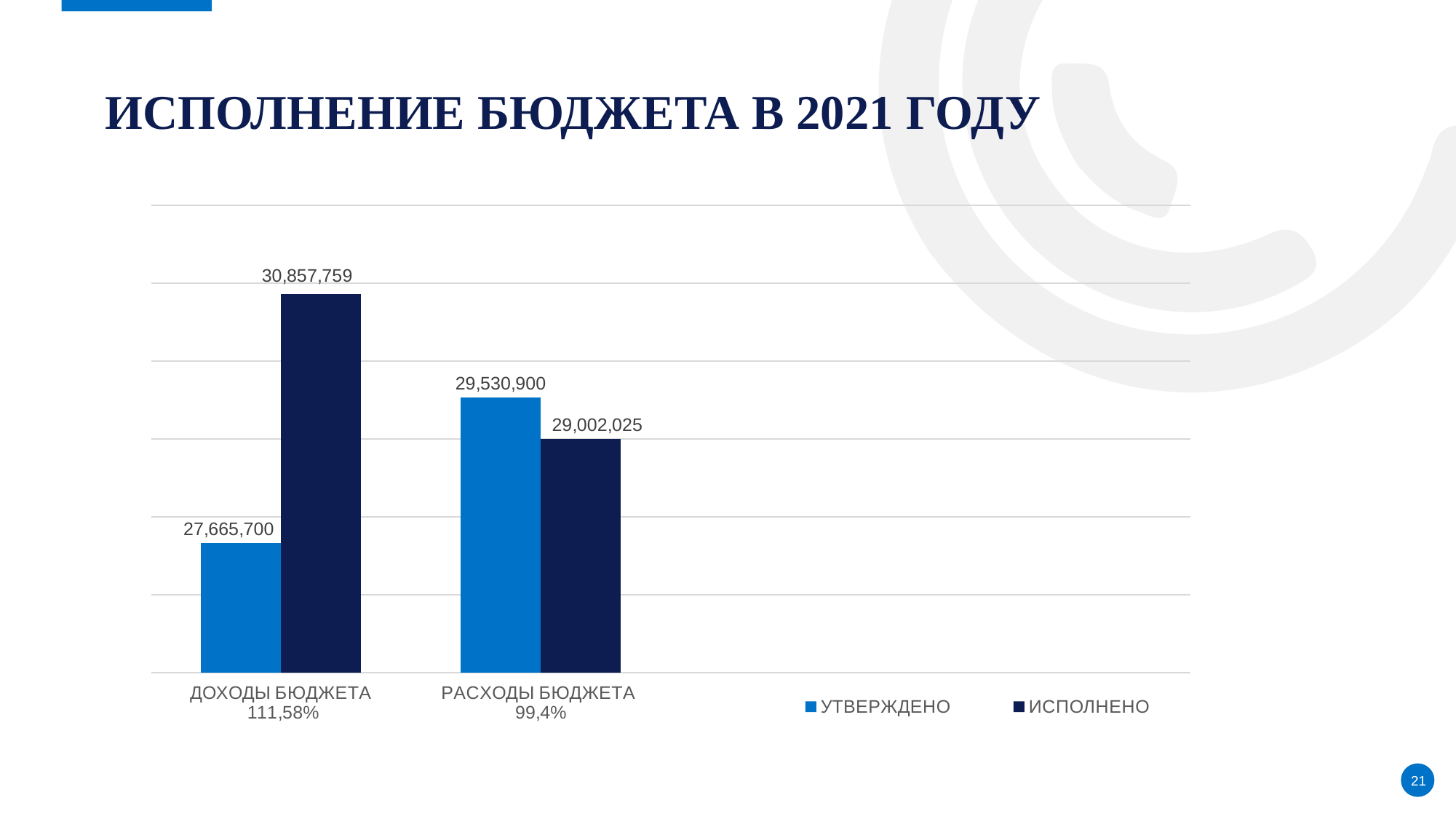
What is the difference between the УТВЕРЖДЕНО and ИСПОЛНЕНО values for РАСХОДЫ БЮДЖЕТА? 528,875 What type of chart is shown on the slide? Bar chart What is the УТВЕРЖДЕНО value for ДОХОДЫ БЮДЖЕТА? 27,665,700 How many categories are shown on the x axis? 2 Which bar has the lowest value on the chart? УТВЕРЖДЕНО for ДОХОДЫ БЮДЖЕТА How many series does the legend list? 2 What is the difference between the ИСПОЛНЕНО and УТВЕРЖДЕНО values for ДОХОДЫ БЮДЖЕТА? 3,192,059 Which bar has the highest value on the chart? ИСПОЛНЕНО for ДОХОДЫ БЮДЖЕТА For РАСХОДЫ БЮДЖЕТА, which is larger: УТВЕРЖДЕНО or ИСПОЛНЕНО? УТВЕРЖДЕНО What is the ИСПОЛНЕНО value for РАСХОДЫ БЮДЖЕТА? 29,002,025 What is the УТВЕРЖДЕНО value for РАСХОДЫ БЮДЖЕТА? 29,530,900 What is the ИСПОЛНЕНО value for ДОХОДЫ БЮДЖЕТА? 30,857,759